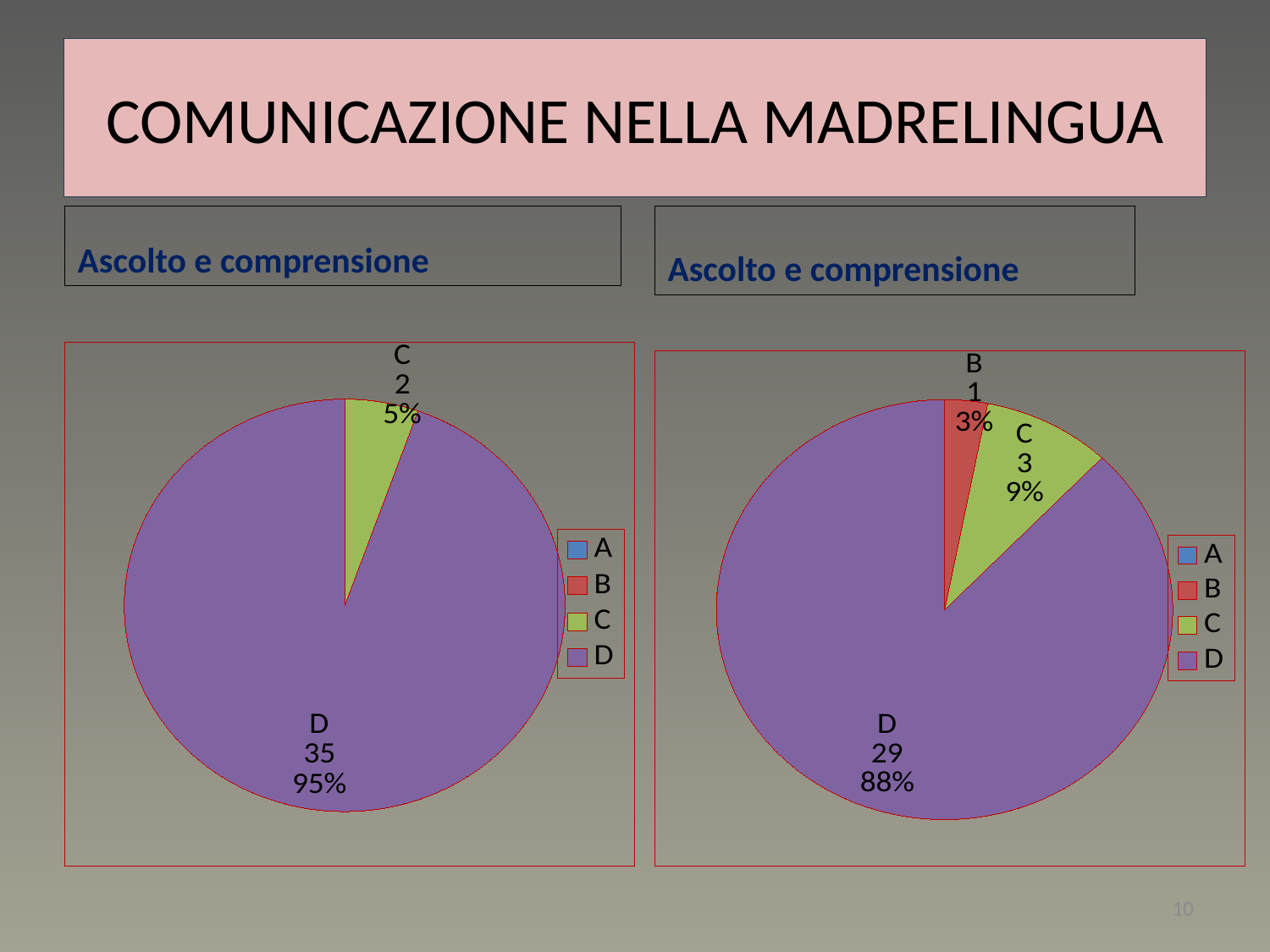
In the left pie chart, what share of the pie does category C have? 5% In the right pie chart, what is the value for category B? 1 In the right pie chart, which labelled category has the smallest slice? B What type of chart is shown on the right side of the slide? Pie chart In the left pie chart, what is the value for category D? 35 What is the title shown above the left chart? Ascolto e comprensione How many entries does the legend of the left pie chart list? 4 In the left pie chart, what is the difference between the values for D and C? 33 In the right pie chart, which category has the largest slice? D In the right pie chart, what is the value for category C? 3 In the right pie chart, which is larger, the value for C or the value for B? C In the right pie chart, what share of the pie does category D have? 88%